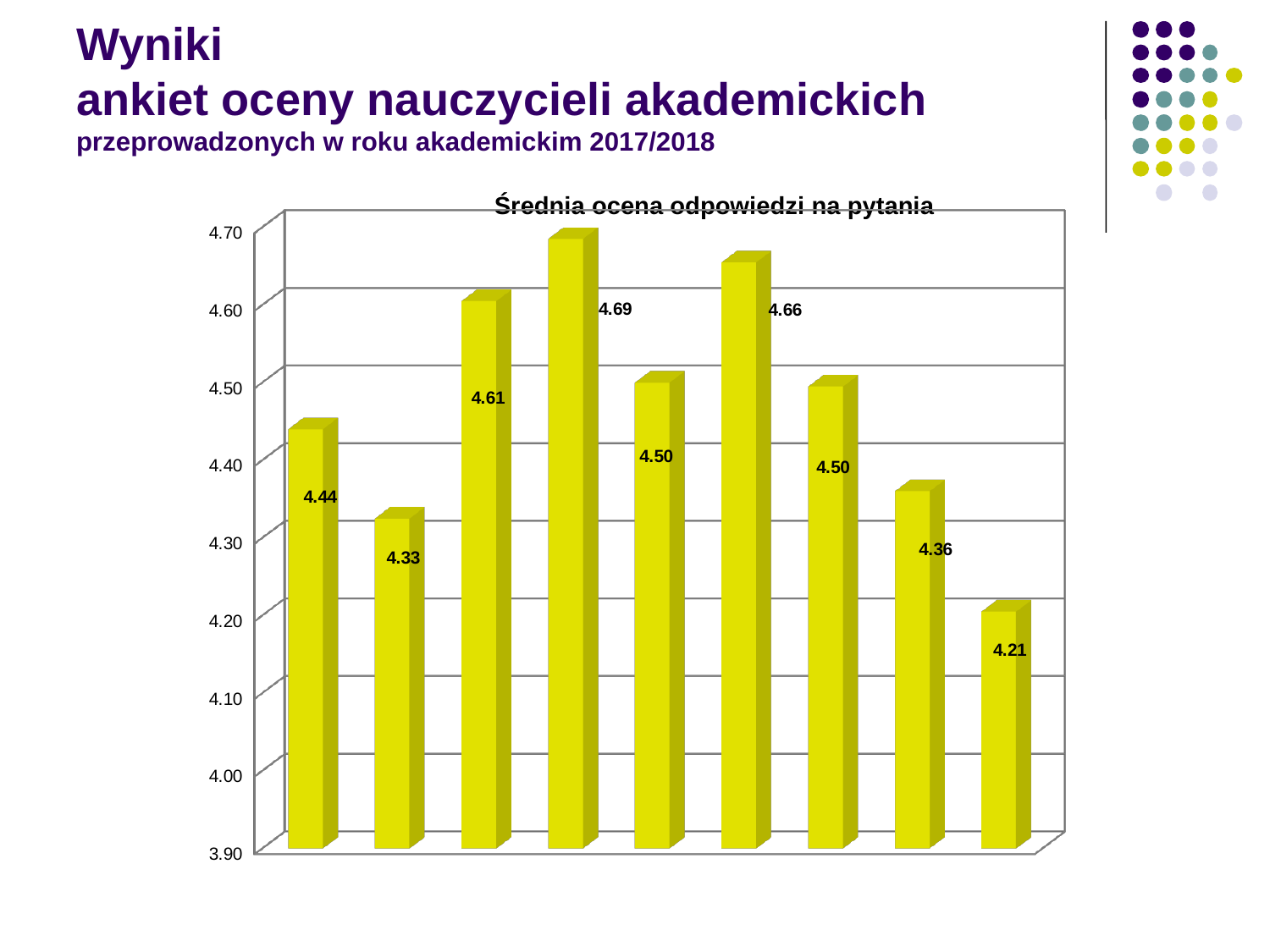
What is the value of the first (leftmost) bar? 4.44 Which is larger: the value of the third bar (4.61) or the value of the sixth bar (4.66)? 4.66 What is the title of the chart? Średnia ocena odpowiedzi na pytania What is the value of the last (rightmost) bar? 4.21 What kind of chart is shown on the slide? bar chart How many bars does the chart contain? 9 Is the value of the second bar from the left greater or less than 4.40? less What is the difference between the highest value (4.69) and the lowest value (4.21)? 0.48 What is the difference between the first bar (4.44) and the second bar (4.33)? 0.11 What is the value of the fourth bar from the left? 4.69 What is the highest value shown in the chart? 4.69 What is the lowest value shown in the chart? 4.21